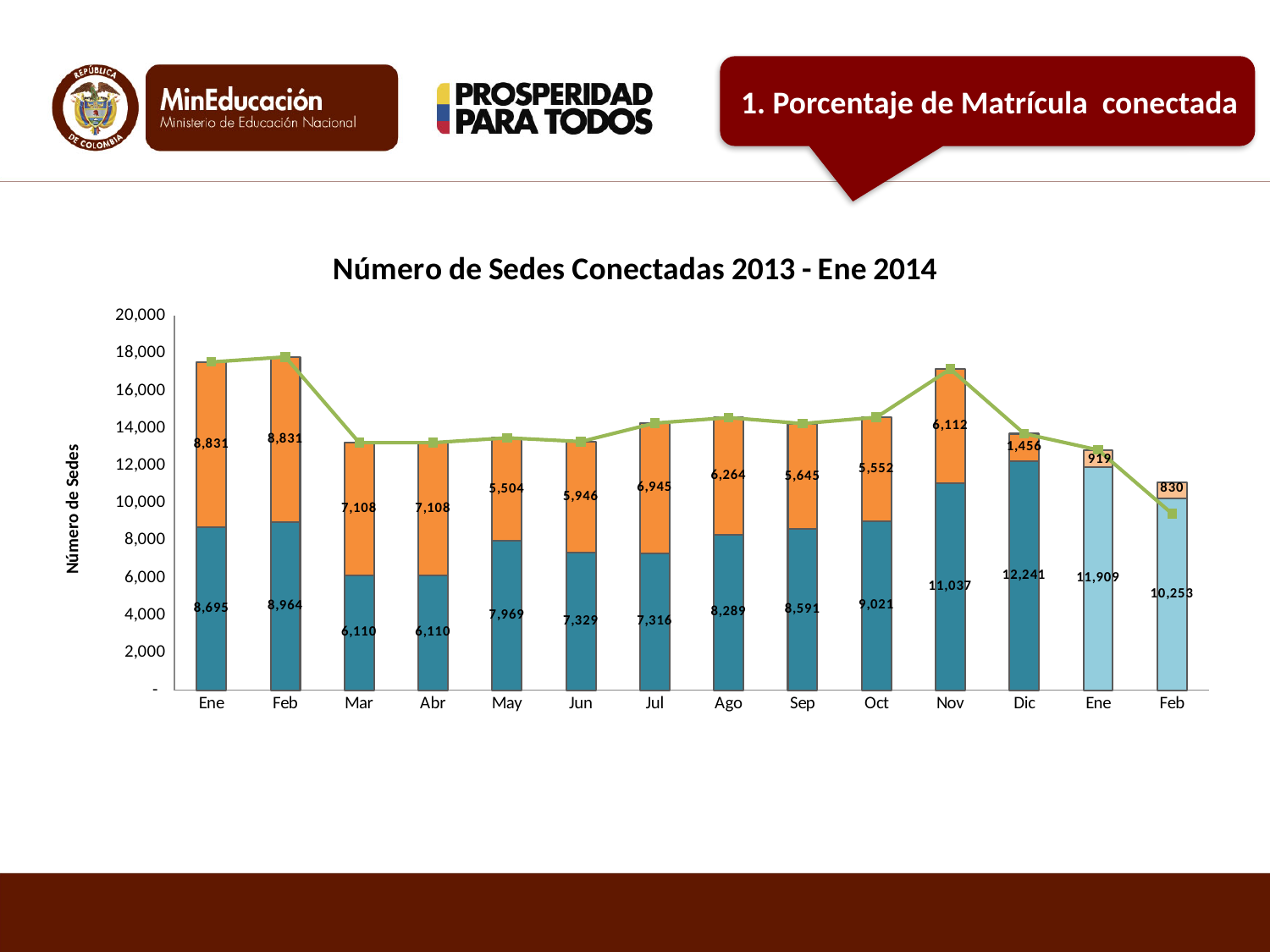
What is the value of the upper segment of the Dic bar? 1,456 Which bar has the smallest upper segment? the last Feb bar (830) Which is larger, the lower segment of Oct or the lower segment of Sep? Oct (9,021) Which month has the highest value for the lower (dark blue) segment? Dic (12,241) What is the difference between the lower segment values of Dic and Nov? 1,204 Is the total height of the Nov bar greater or less than 16,000? greater What is the total height of the Mar bar (sum of its two segments)? 13,218 How many month categories are shown along the x axis? 14 What is the value of the lower (dark blue) segment of the Nov bar? 11,037 Does the green line rise or fall from Nov to the final Feb? falls What is the value of the upper (orange) segment of the Jul bar? 6,945 What kind of chart is shown on the slide? bar chart (stacked bars with a line overlay)